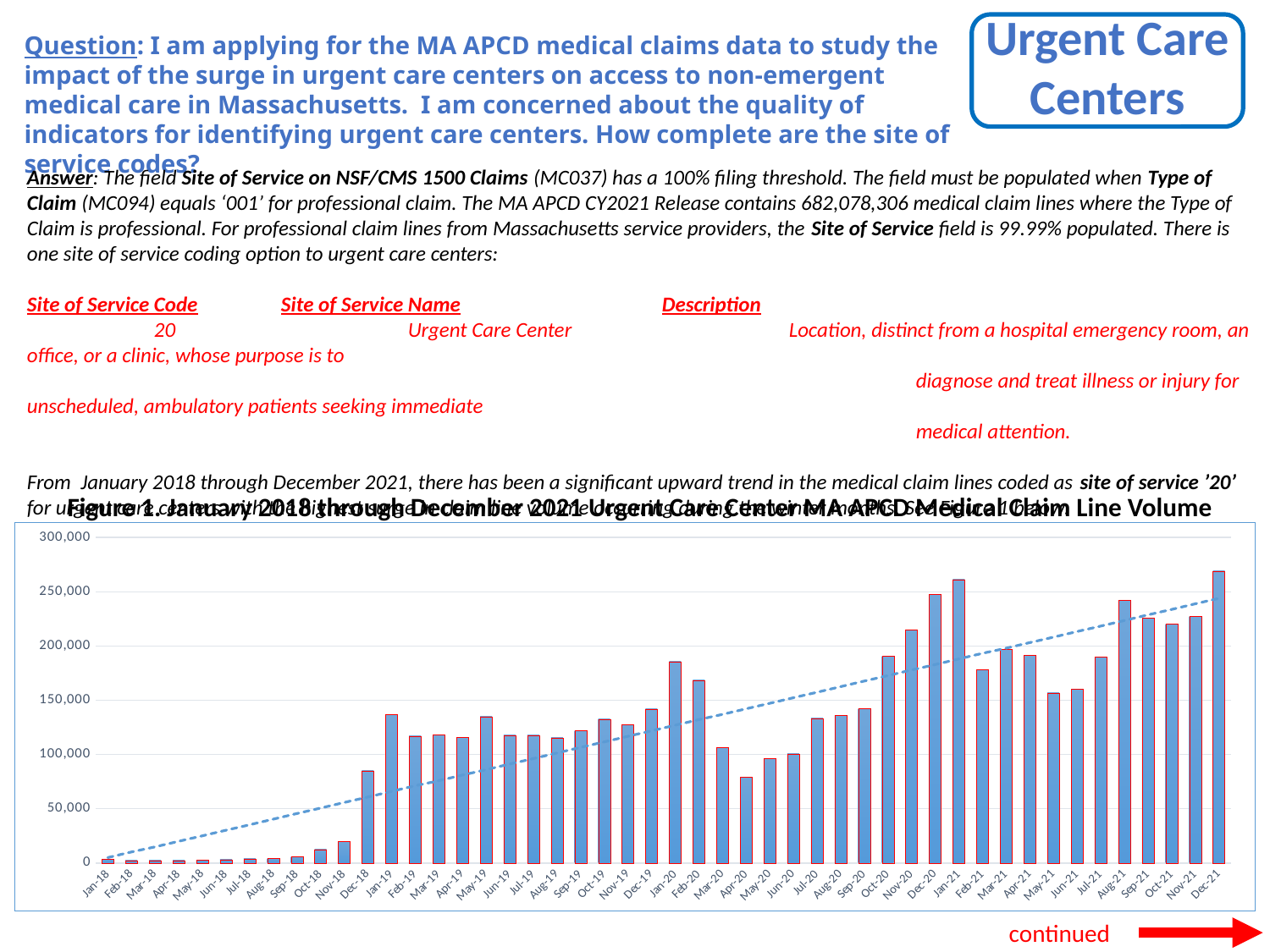
What is the highest value shown on the chart's vertical axis? 300,000 Which month has the highest claim line volume? Dec-21 Is the value for Feb-21 greater or less than 200,000? less Is the value for Jan-20 greater or less than 150,000? greater Is the value for Dec-21 greater or less than 250,000? greater What kind of chart is shown on the slide? bar chart Do the claim line volumes generally rise or fall from Jan-18 to Dec-21? rise Which is larger, the value for Jan-21 or the value for Feb-21? Jan-21 Which is larger, the value for Jan-20 or the value for Apr-20? Jan-20 How many monthly bars are plotted in the chart? 48